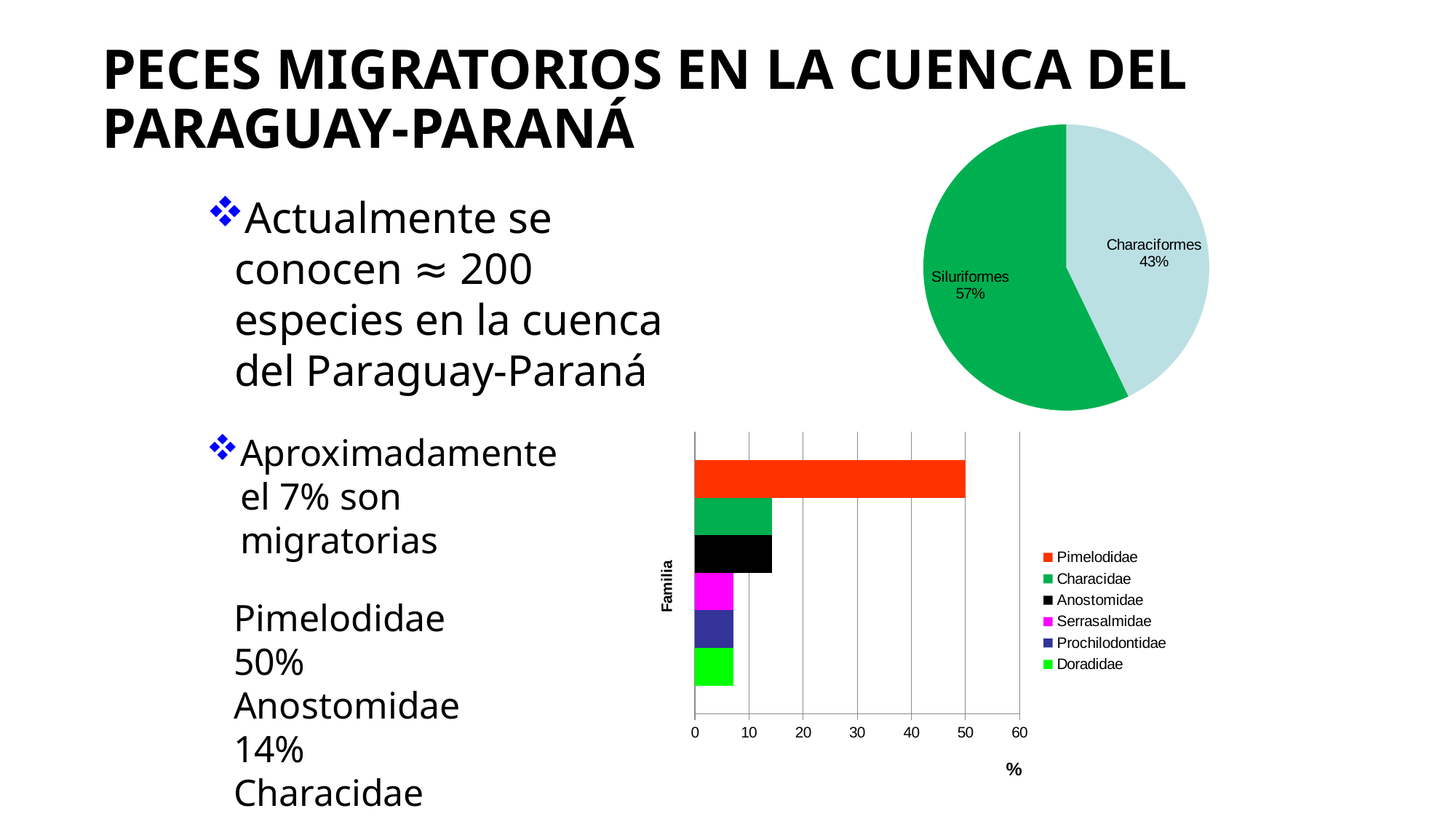
In the bar chart, which family has the longest bar? Pimelodidae In the bar chart, is the value for Doradidae greater or less than 10? less In the pie chart, which order has the larger slice? Siluriformes In the pie chart, how many percentage points larger is the Siluriformes slice than the Characiformes slice? 14 What is the label of the horizontal axis of the bar chart? % What kind of chart is the chart at the bottom of the slide with the Familia axis? Bar chart In the bar chart, which is larger, the value for Pimelodidae or the value for Characidae? Pimelodidae In the pie chart, what percentage is shown for Characiformes? 43% How many entries does the legend of the bar chart list? 6 How many slices does the pie chart have? 2 In the bar chart, what value does the Pimelodidae bar reach on the % axis? 50 In the pie chart, what percentage is shown for Siluriformes? 57%